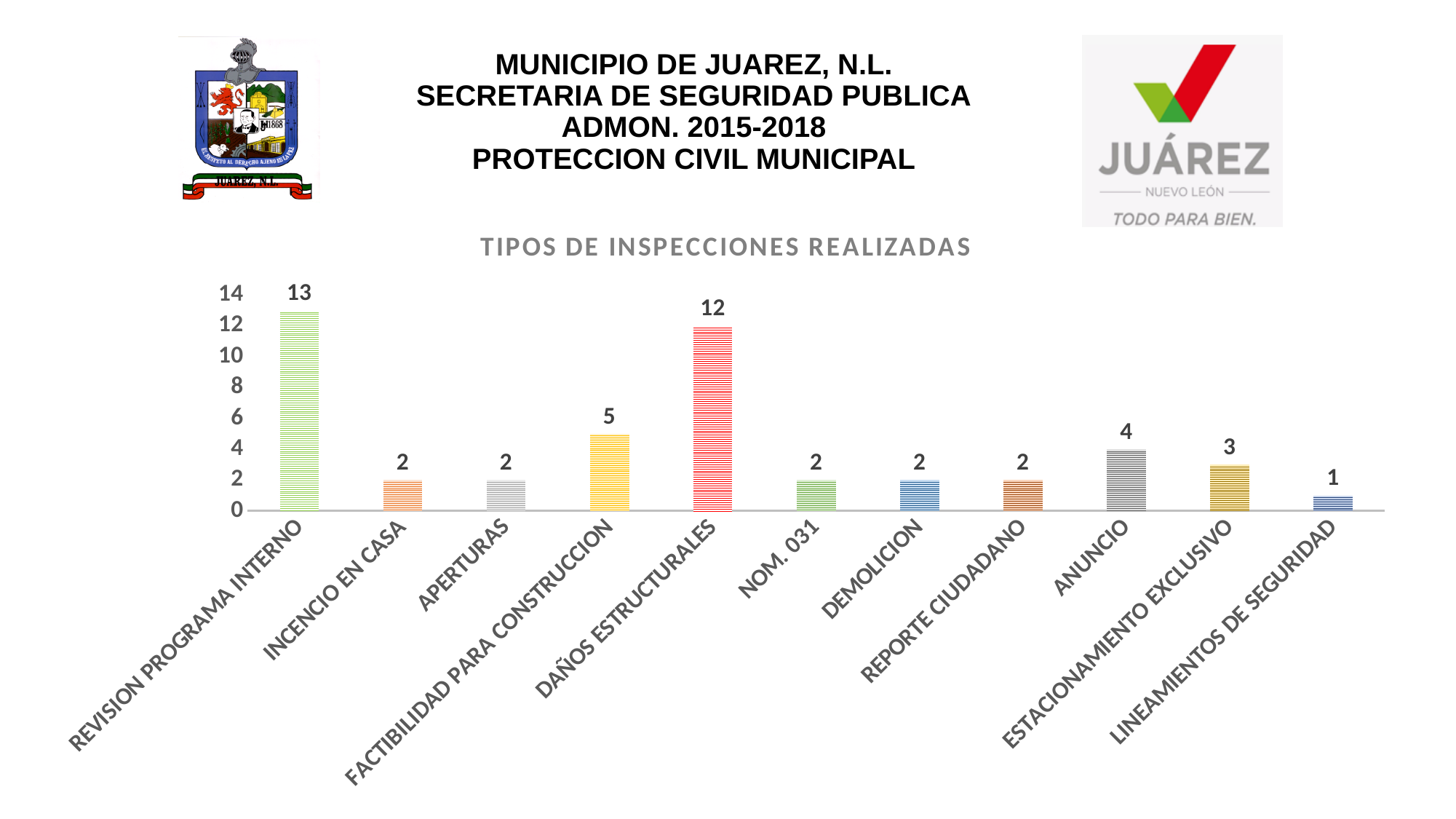
What is the value for FACTIBILIDAD PARA CONSTRUCCION? 5 What is the value for REVISION PROGRAMA INTERNO? 13 Is the value for DAÑOS ESTRUCTURALES greater or less than 10? greater How many categories are shown on the x axis? 11 Which category has the lowest value? LINEAMIENTOS DE SEGURIDAD What is the value for ANUNCIO? 4 Which category has the highest value? REVISION PROGRAMA INTERNO Which is larger, the value for ESTACIONAMIENTO EXCLUSIVO or the value for FACTIBILIDAD PARA CONSTRUCCION? FACTIBILIDAD PARA CONSTRUCCION What is the difference between the values for REVISION PROGRAMA INTERNO and DAÑOS ESTRUCTURALES? 1 What kind of chart is shown on the slide? bar chart What is the title of the chart? TIPOS DE INSPECCIONES REALIZADAS What is the value for DAÑOS ESTRUCTURALES? 12